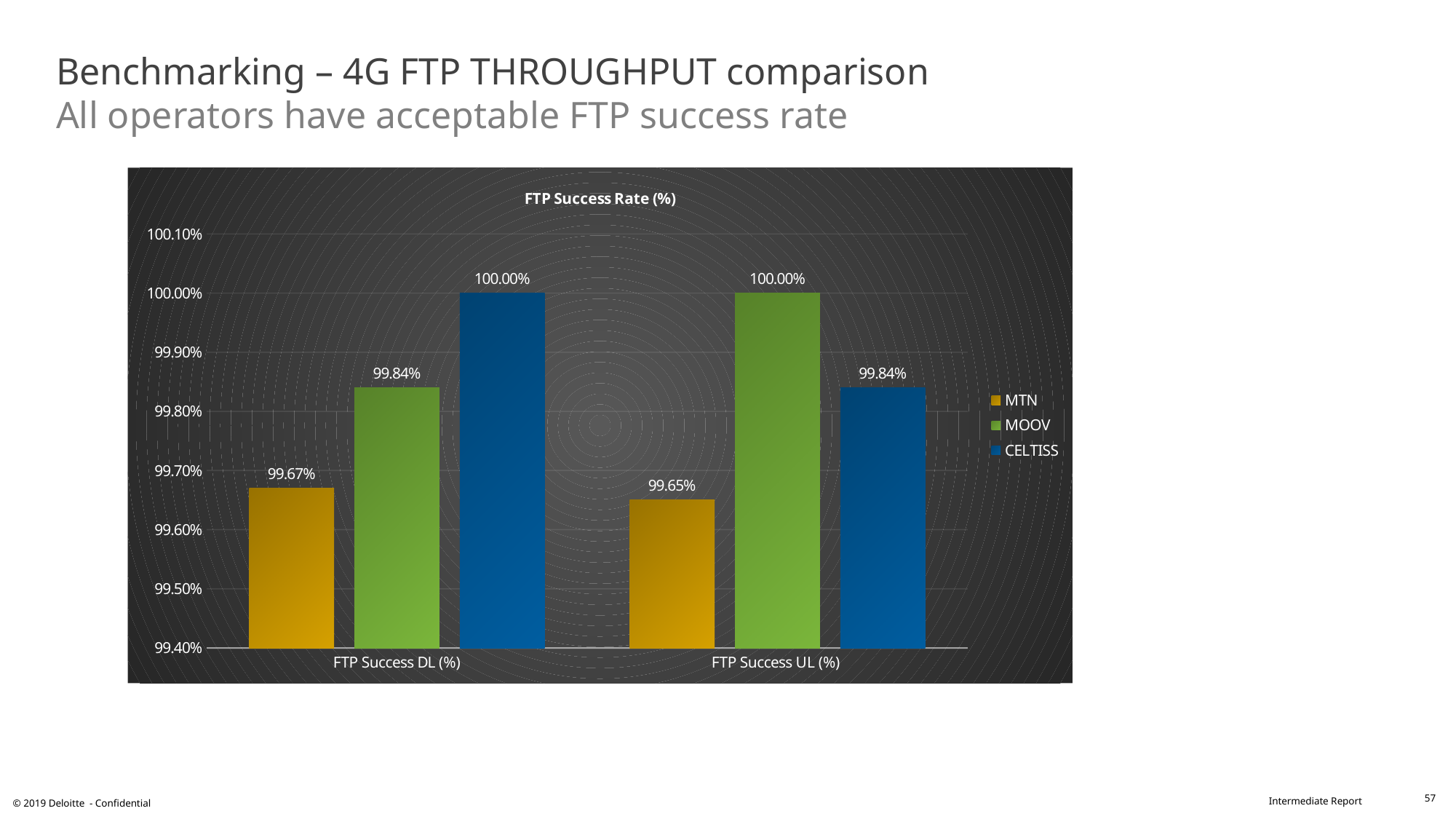
What is the FTP Success UL (%) value for CELTISS? 99.84% How many series does the legend list? 3 What is the FTP Success DL (%) value for MTN? 99.67% Which is larger: MOOV's FTP Success DL (%) or MOOV's FTP Success UL (%)? FTP Success UL (%) What is the title of the chart? FTP Success Rate (%) How many categories are shown on the x axis? 2 Is the FTP Success UL (%) value for MTN greater or less than 99.70%? less What is the FTP Success UL (%) value for MOOV? 100.00% What is the difference between CELTISS and MTN for FTP Success DL (%)? 0.33% What kind of chart is shown? bar chart Which operator has the highest FTP Success DL (%)? CELTISS Which operator has the lowest FTP Success UL (%)? MTN